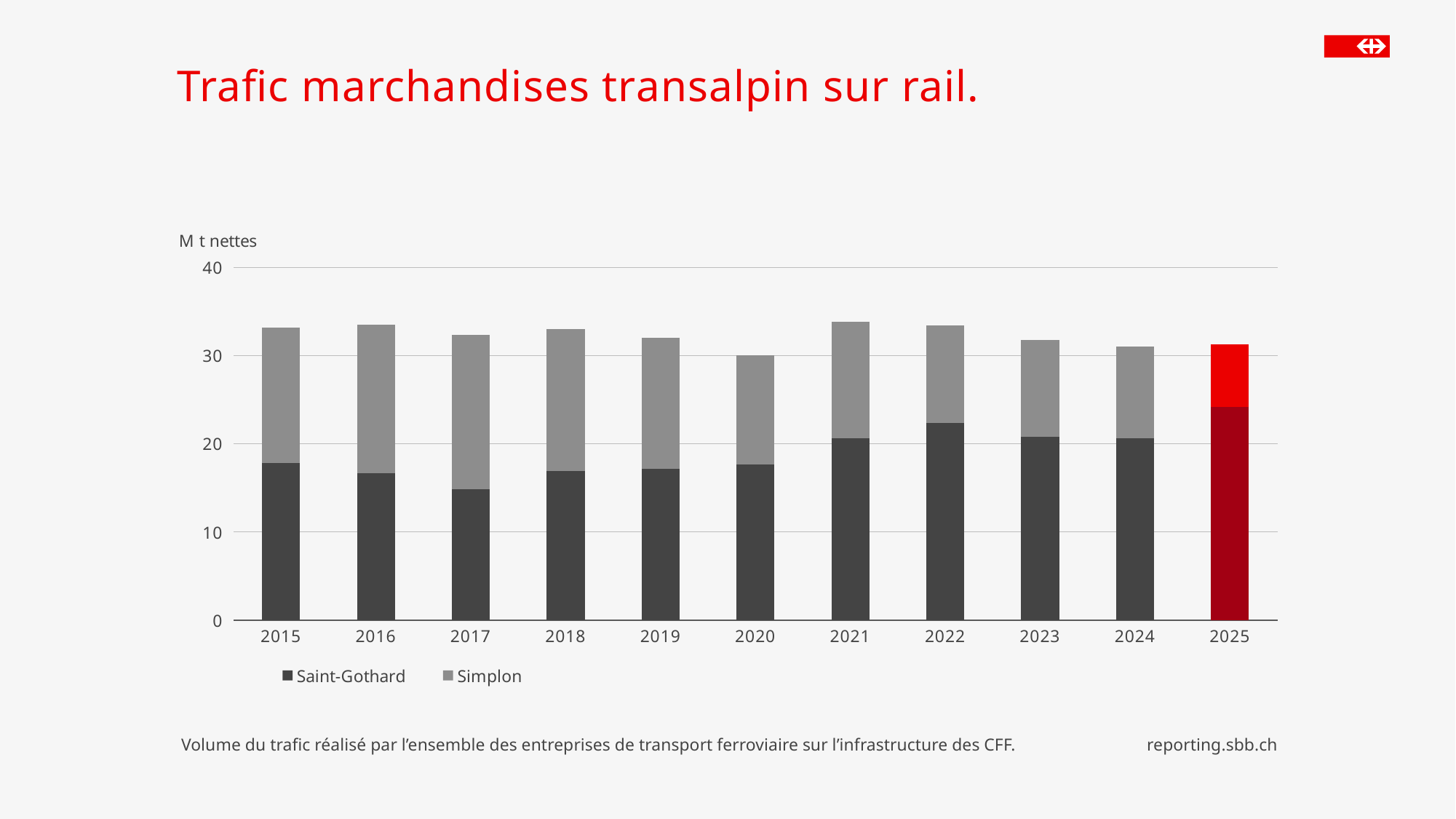
What kind of chart is shown on the slide? Stacked bar chart Which year has the lowest total stacked bar? 2020 What unit is shown on the y axis of the chart? M t nettes Which year has the lowest Saint-Gothard value? 2017 Is the total stacked bar for 2021 greater or less than 30? greater Which year has the highest Saint-Gothard value? 2025 What is the title of the slide? Trafic marchandises transalpin sur rail. Is the Saint-Gothard value for 2022 greater or less than 20? greater Is the Saint-Gothard value for 2017 greater or less than 20? less Which is larger, the Saint-Gothard value for 2022 or for 2017? 2022 How many series does the chart legend list? 2 How many years are shown on the x axis of the chart? 11